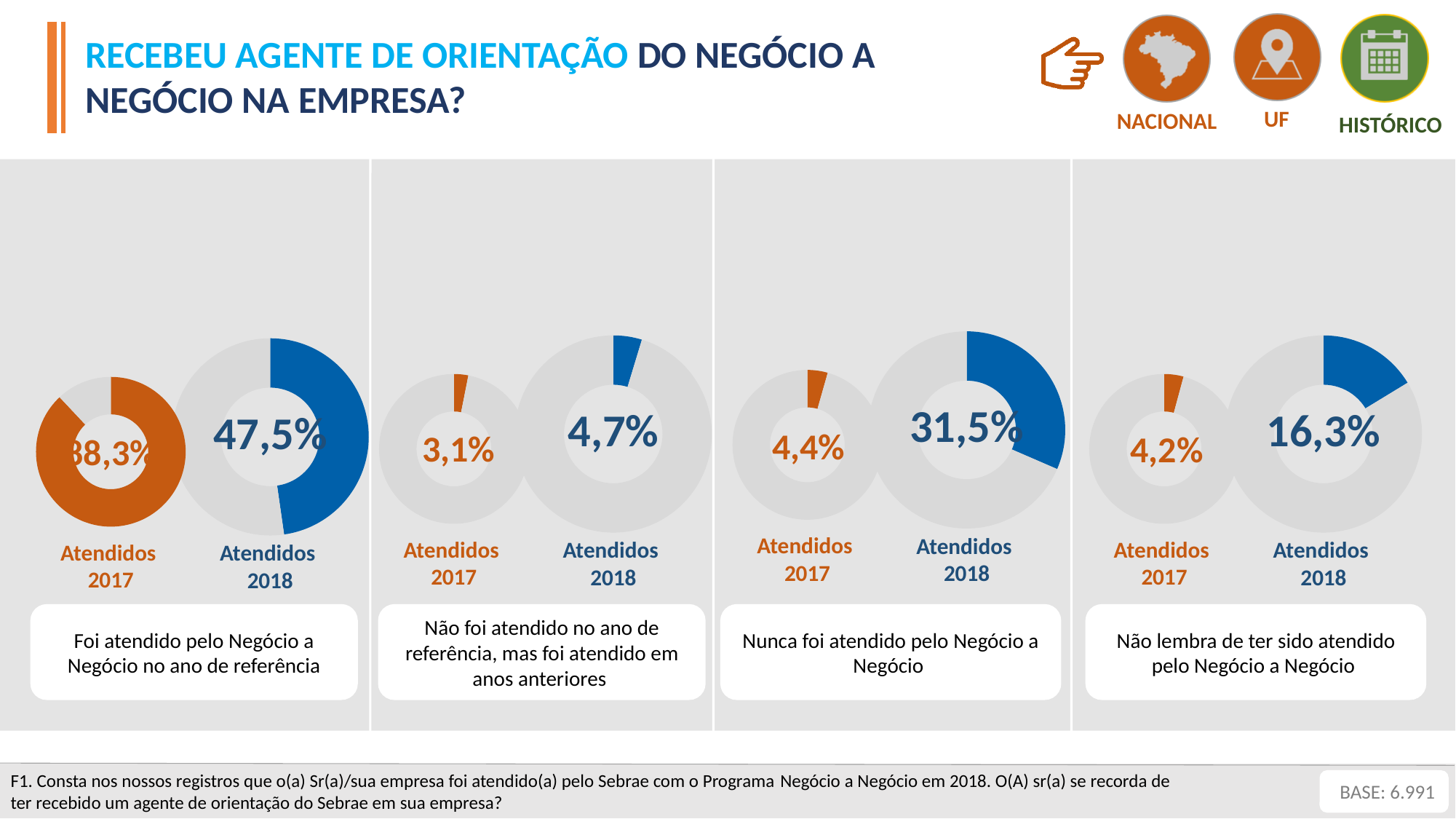
In the panel 'Não foi atendido no ano de referência, mas foi atendido em anos anteriores', what is the value for Atendidos 2018? 4,7% In the panel 'Nunca foi atendido pelo Negócio a Negócio', by how many percentage points does the Atendidos 2018 value exceed the Atendidos 2017 value? 27,1 percentage points Among the four Atendidos 2018 donut charts, which category has the highest value? Foi atendido pelo Negócio a Negócio no ano de referência (47,5%) In the panel 'Nunca foi atendido pelo Negócio a Negócio', what is the value for Atendidos 2017? 4,4% In the panel 'Não foi atendido no ano de referência, mas foi atendido em anos anteriores', what is the value for Atendidos 2017? 3,1% In the panel 'Nunca foi atendido pelo Negócio a Negócio', what is the value for Atendidos 2018? 31,5% In the panel 'Não lembra de ter sido atendido pelo Negócio a Negócio', what is the value for Atendidos 2017? 4,2% Which is larger: the Atendidos 2018 value for 'Nunca foi atendido pelo Negócio a Negócio' or the Atendidos 2018 value for 'Não lembra de ter sido atendido pelo Negócio a Negócio'? Nunca foi atendido pelo Negócio a Negócio (31,5%) Among the four Atendidos 2018 donut charts, which category has the lowest value? Não foi atendido no ano de referência, mas foi atendido em anos anteriores (4,7%) In the panel 'Foi atendido pelo Negócio a Negócio no ano de referência', what is the value for Atendidos 2018? 47,5% What kind of charts are used on this slide? Donut (pie) charts In the panel 'Não lembra de ter sido atendido pelo Negócio a Negócio', what is the value for Atendidos 2018? 16,3%